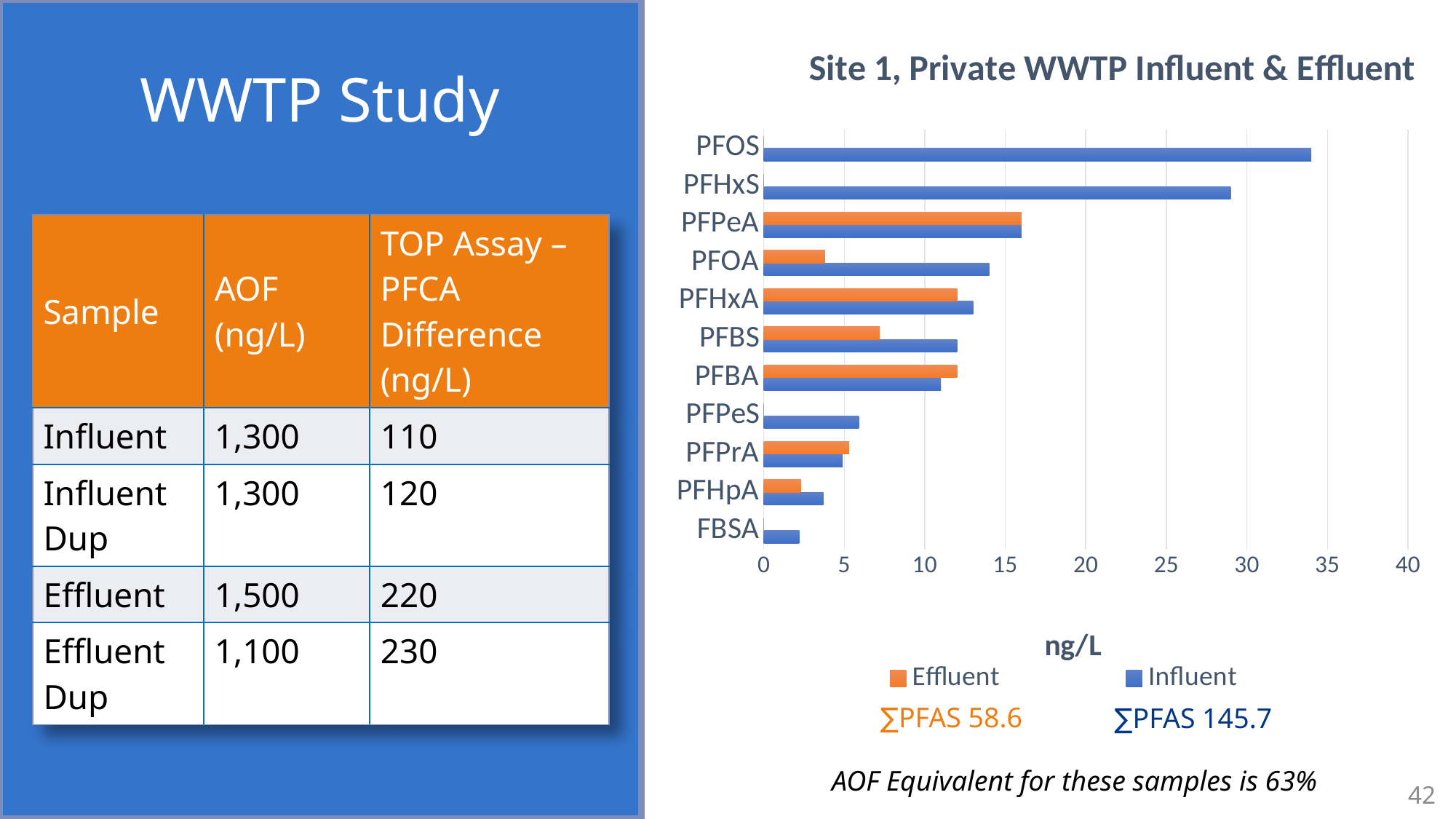
Is the Influent value for PFHxS greater or less than 25? greater What ∑PFAS value is shown for the Effluent series in the legend? 58.6 What kind of chart is shown on the slide? bar chart How many PFAS compounds (categories) are plotted on the chart? 11 Which compound has the lowest Influent value? FBSA Is the Influent value for PFOS greater or less than 30? greater How many series does the chart legend list? 2 Is the Effluent value for PFOA greater or less than 5? less For PFBS, which is larger, the Influent or the Effluent value? Influent For PFOA, which is larger, the Influent or the Effluent value? Influent Which compound has the highest Influent value? PFOS